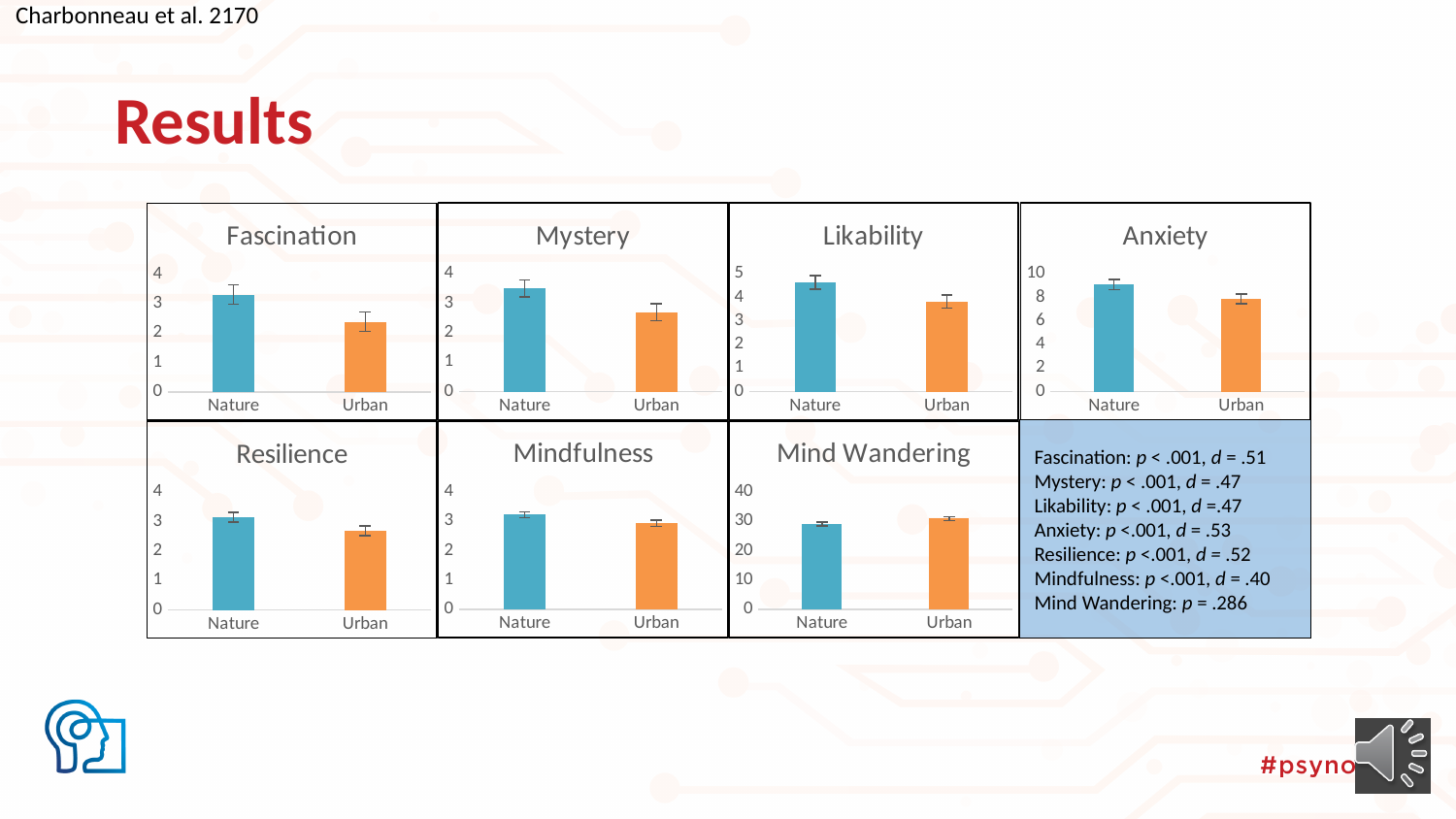
In the Fascination chart, which is larger, Nature or Urban? Nature How many charts are shown on the slide? 7 In the Fascination chart, is the value for Urban greater or less than 3? less In the Likability chart, is the value for Nature greater or less than 4? greater In the Fascination chart, is the value for Nature greater or less than 3? greater What kind of chart is the Mindfulness chart? bar chart In the Anxiety chart, which is larger, Nature or Urban? Nature In the Mind Wandering chart, how many categories are shown on the x axis? 2 In the Resilience chart, which category has the highest value? Nature